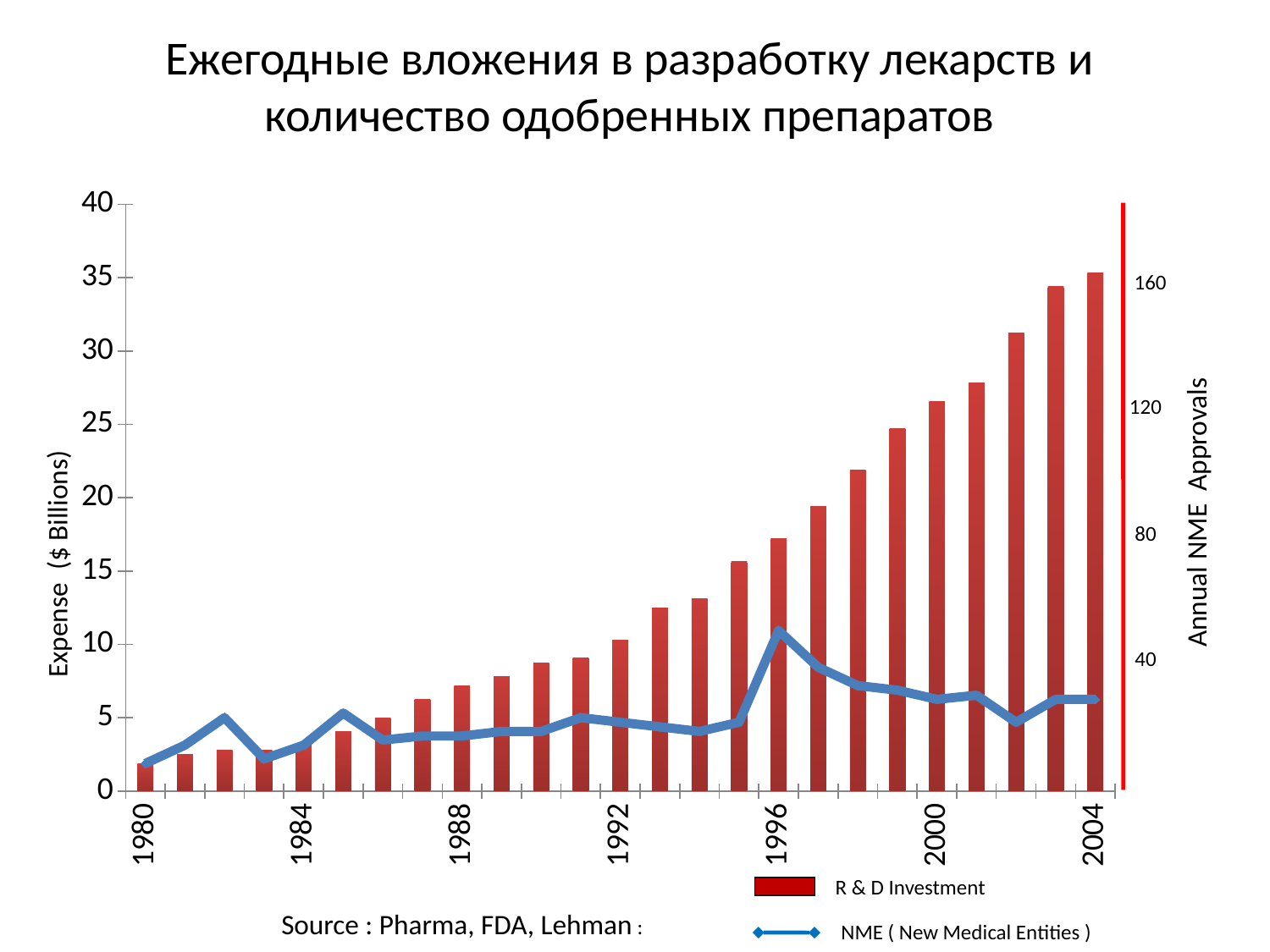
Is the R & D Investment value for 2004 greater or less than 30? greater Which year has the tallest R & D Investment bar? 2004 Which year has the shortest R & D Investment bar? 1980 In which year does the NME (New Medical Entities) line reach its peak? 1996 Is the R & D Investment value for 1988 greater or less than 10? less What is the title of the left vertical axis? Expense ($ Billions) What kind of chart is shown on the slide? A combined bar and line chart Is the R & D Investment value for 2000 greater or less than 25? greater How many year labels are shown on the x axis? 7 How many series does the legend list? 2 Do the R & D Investment bars generally rise or fall from 1980 to 2004? rise Which year has the larger R & D Investment bar, 1996 or 2000? 2000